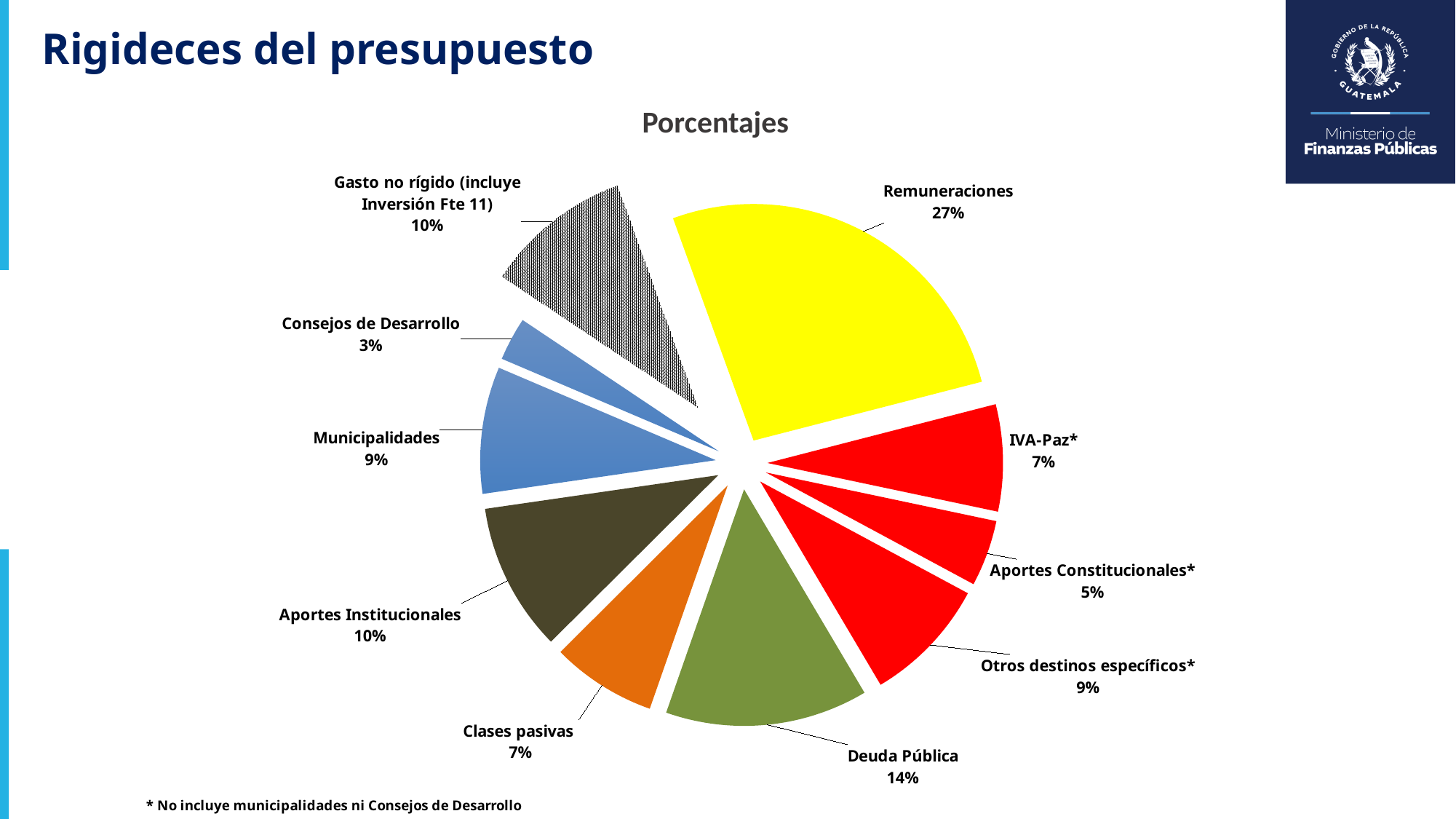
Which is larger, the share for Municipalidades or the share for IVA-Paz*? Municipalidades What percentage is shown for Aportes Constitucionales*? 5% What is the title of the chart? Porcentajes What is the difference in percentage points between Remuneraciones and Deuda Pública? 13 What percentage is shown for Consejos de Desarrollo? 3% What colour is the Remuneraciones slice? Yellow How many slices does the pie chart have? 10 Which category has the smallest share of the pie? Consejos de Desarrollo What percentage is shown for Remuneraciones? 27% What kind of chart is shown on the slide? Pie chart Which category has the largest share of the pie? Remuneraciones What percentage is shown for Deuda Pública? 14%